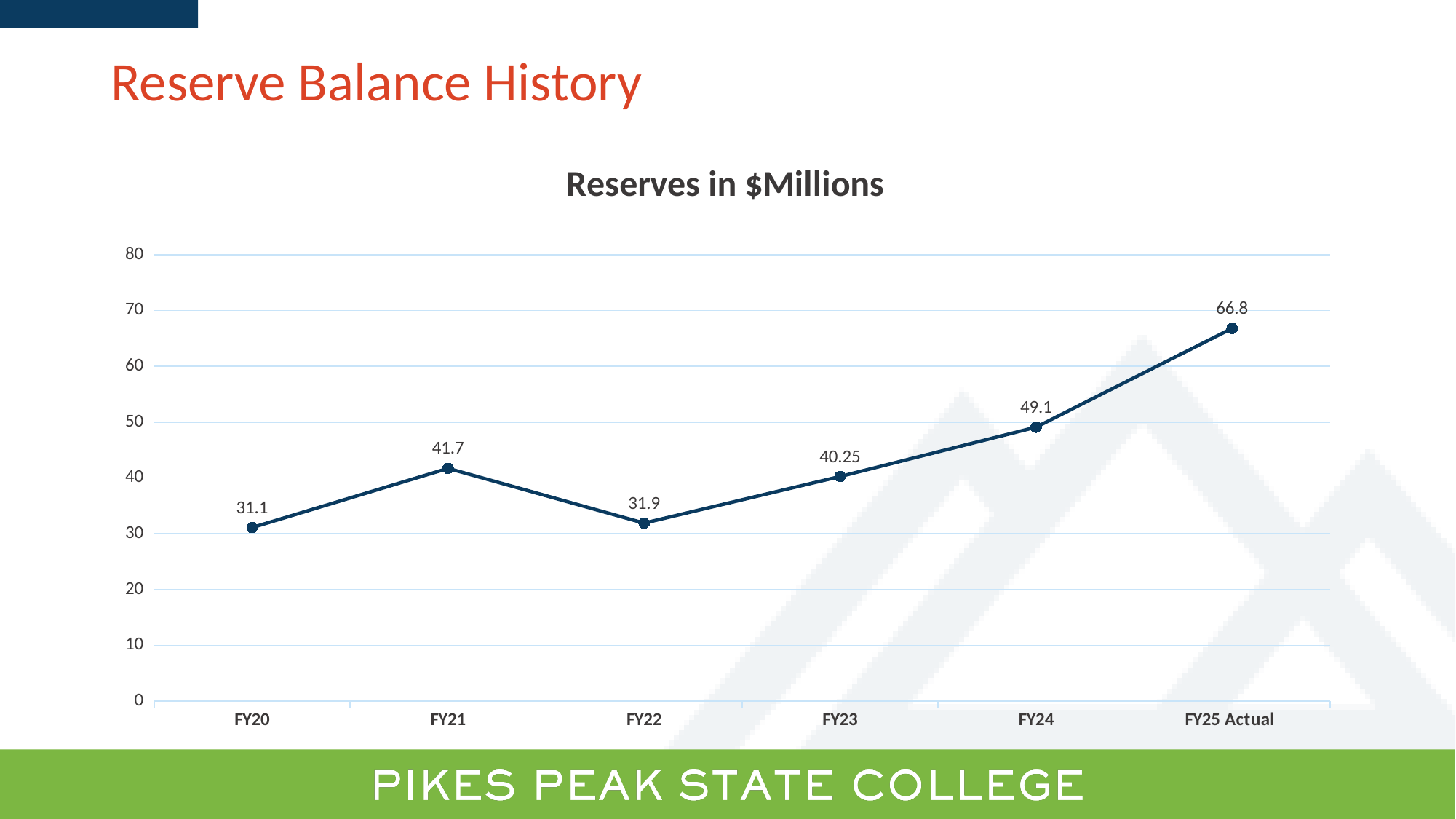
What is the reserve value for FY25 Actual? 66.8 Which fiscal year has the highest reserve value? FY25 Actual What is the difference between the FY21 and FY22 reserve values? 9.8 What kind of chart is shown on the slide? line chart What is the reserve value for FY23? 40.25 Which fiscal year has the lowest reserve value? FY20 Is the reserve value for FY24 greater or less than 40? greater Which is larger, the reserve value for FY21 or FY23? FY21 How many fiscal years are plotted on the chart? 6 What is the title of the chart? Reserves in $Millions What is the reserve value for FY20? 31.1 What is the difference between the FY25 Actual and FY24 reserve values? 17.7